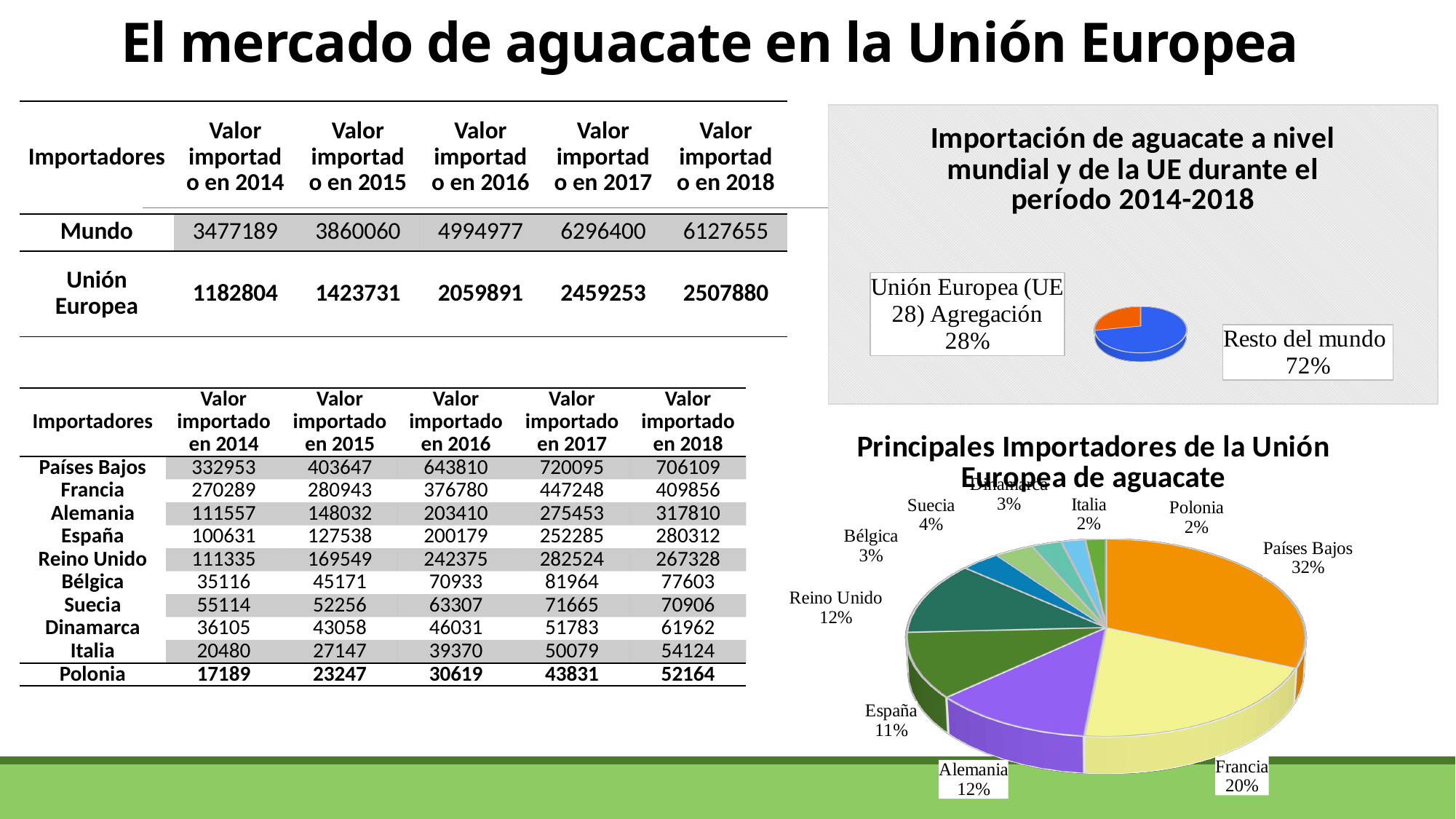
In the pie chart titled 'Principales Importadores de la Unión Europea de aguacate', what share does Suecia have? 4% In the pie chart titled 'Importación de aguacate a nivel mundial y de la UE durante el período 2014-2018', how many slices are there? 2 In the pie chart titled 'Principales Importadores de la Unión Europea de aguacate', which has the larger share, Suecia or Bélgica? Suecia In the pie chart titled 'Principales Importadores de la Unión Europea de aguacate', what share does Francia have? 20% What kind of chart is the one titled 'Principales Importadores de la Unión Europea de aguacate'? Pie chart In the pie chart titled 'Importación de aguacate a nivel mundial y de la UE durante el período 2014-2018', what share does 'Unión Europea (UE 28) Agregación' have? 28% In the pie chart titled 'Principales Importadores de la Unión Europea de aguacate', which country has the largest share? Países Bajos In the pie chart titled 'Principales Importadores de la Unión Europea de aguacate', how many countries are shown as slices? 10 In the pie chart titled 'Principales Importadores de la Unión Europea de aguacate', what is the difference in percentage points between Países Bajos and Francia? 12